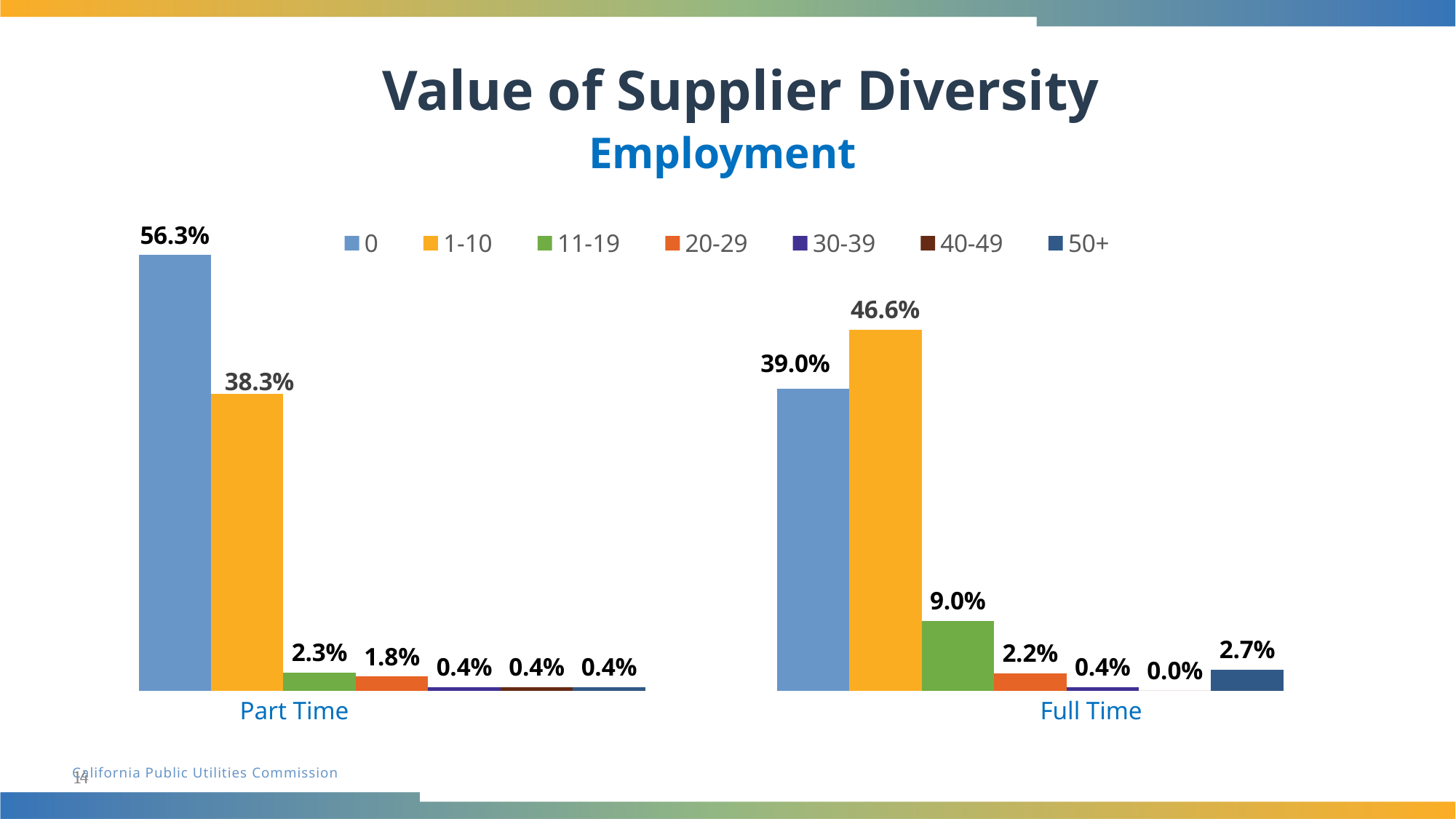
What is the value for the 0 series in the Part Time category? 56.3% What is the difference between the 0 series values for Part Time and Full Time? 17.3% How many categories are shown on the x axis? 2 What is the value for the 1-10 series in the Full Time category? 46.6% What is the value for the 50+ series in the Full Time category? 2.7% Which series has the highest value in the Part Time category? 0 How many series does the legend list? 7 Which is larger in the Full Time category: the 0 series or the 1-10 series? 1-10 What is the subtitle shown below the chart title? Employment What kind of chart is shown on the slide? bar chart Which series has the lowest value in the Full Time category? 40-49 What is the value for the 11-19 series in the Full Time category? 9.0%